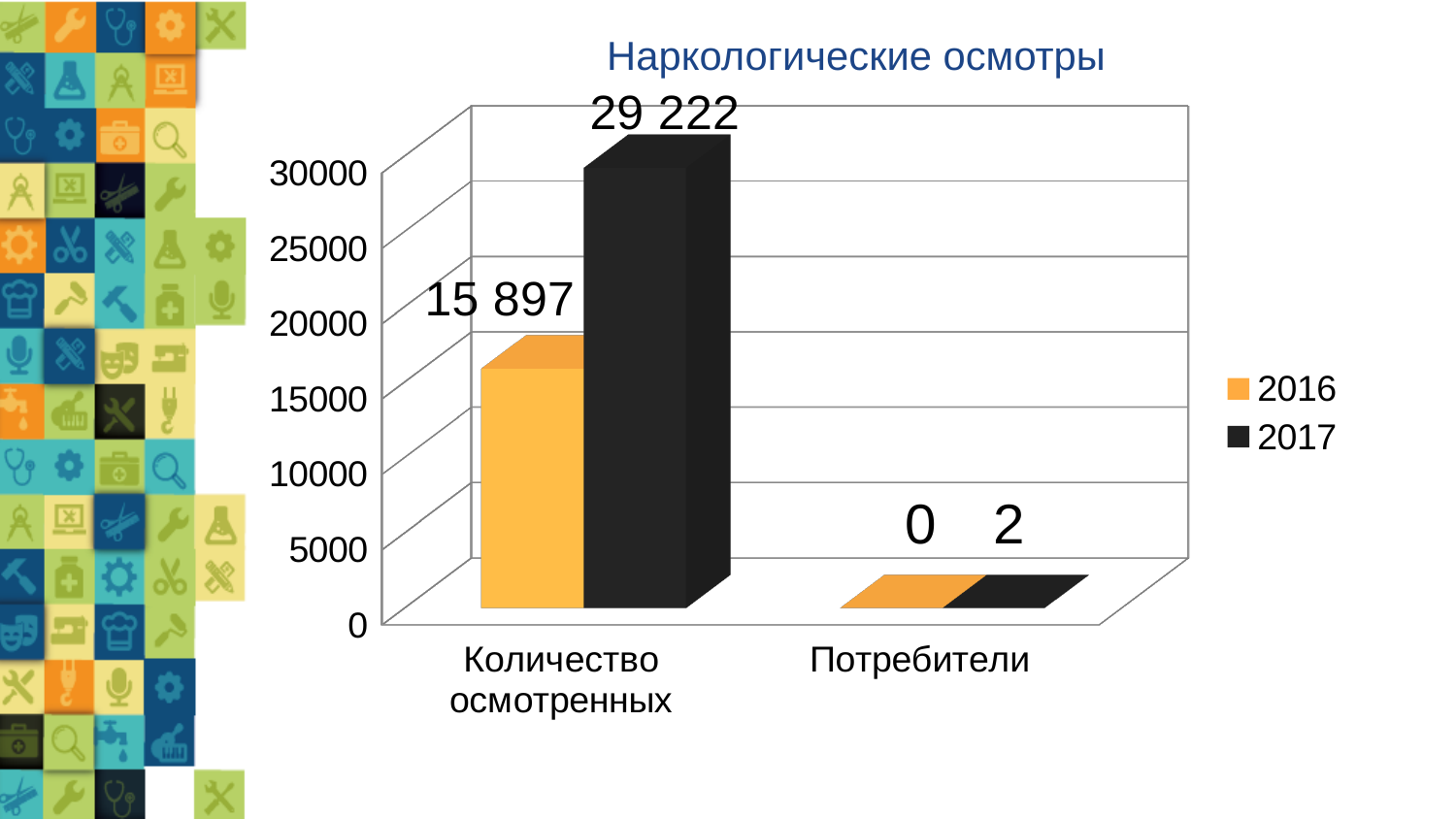
What is the value for 2017 in the "Количество осмотренных" category? 29 222 What kind of chart is shown on the slide? Bar chart What is the value for 2017 in the "Потребители" category? 2 What is the value for 2016 in the "Потребители" category? 0 Which series has the higher value for "Количество осмотренных", 2016 or 2017? 2017 How many categories are shown on the x axis? 2 How many series does the legend list? 2 What is the difference between the 2017 and 2016 values for "Количество осмотренных"? 13 325 What is the value for 2016 in the "Количество осмотренных" category? 15 897 Which colour represents the 2016 series in the legend? Orange What is the title of the chart? Наркологические осмотры What is the difference between the 2017 and 2016 values for "Потребители"? 2